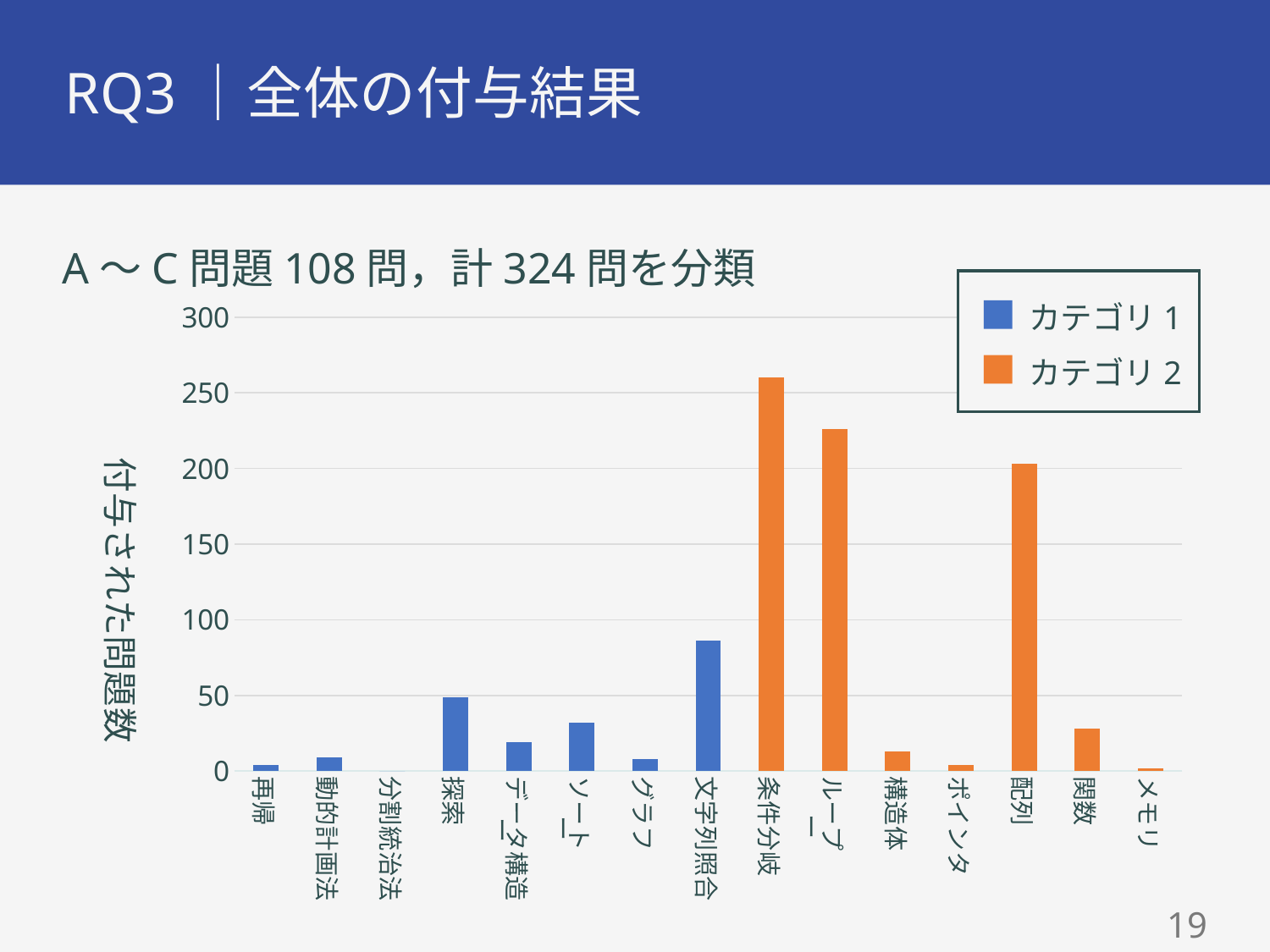
Which category has the highest value? 条件分岐 How many series does the legend list? 2 What kind of chart is shown on the slide? bar chart Which is larger, the value for 条件分岐 or the value for ループ? 条件分岐 Is the value for ループ greater or less than 200? greater Is the value for 文字列照合 greater or less than 100? less How many categories are shown on the x axis? 15 What are the two entries in the legend? カテゴリ 1, カテゴリ 2 What is the title of the y axis? 付与された問題数 Is the value for 条件分岐 greater or less than 250? greater Which is larger, the value for 文字列照合 or the value for 探索? 文字列照合